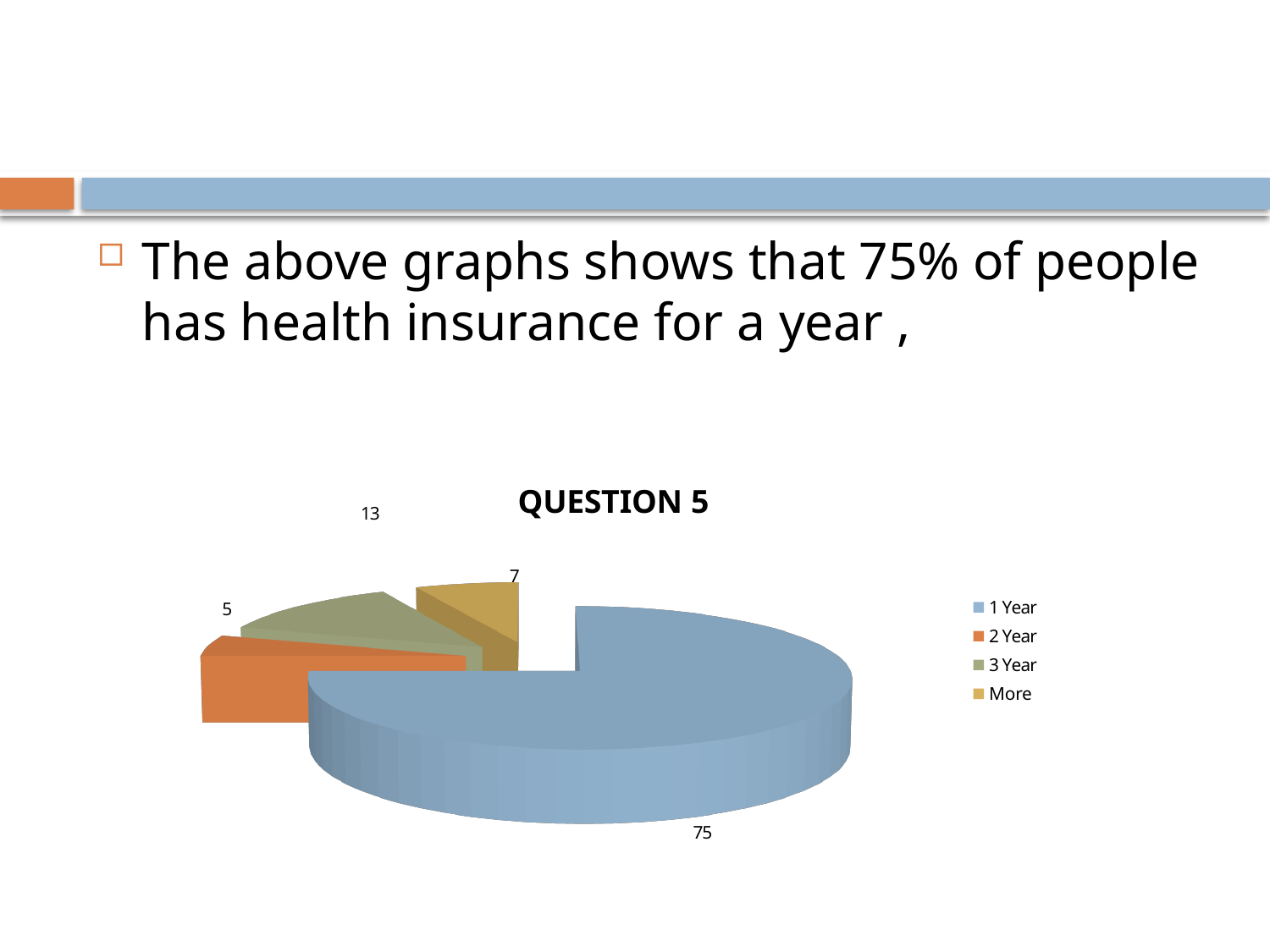
What is the difference between the 1 Year value and the More value in the QUESTION 5 pie chart? 68 Which is larger in the QUESTION 5 pie chart, the 1 Year slice or the More slice? 1 Year What kind of chart is shown on the slide? pie chart Which category has the largest slice in the QUESTION 5 pie chart? 1 Year Which category has the smallest slice in the QUESTION 5 pie chart? 2 Year What is the value for the 1 Year slice in the QUESTION 5 pie chart? 75 What is the value for the 2 Year slice in the QUESTION 5 pie chart? 5 What is the value for the More slice in the QUESTION 5 pie chart? 7 What is the title of the pie chart? QUESTION 5 How many entries are listed in the legend of the QUESTION 5 pie chart? 4 What is the value for the 3 Year slice in the QUESTION 5 pie chart? 13 How many slices does the QUESTION 5 pie chart have? 4